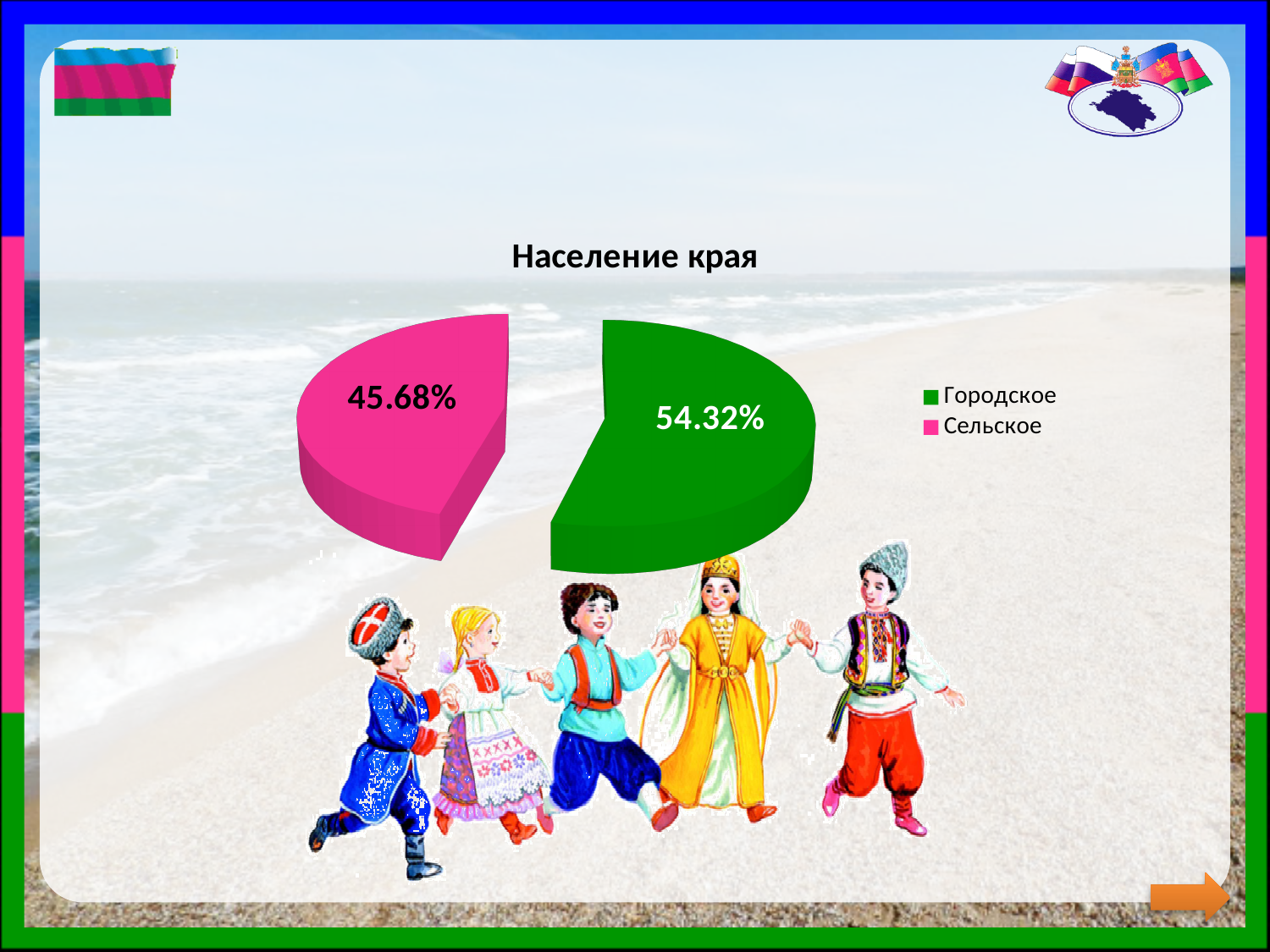
What is the title of the chart? Население края What is the difference between the Городское and Сельское values? 8.64% Which category has the smallest share of the pie? Сельское What is the value for Сельское? 45.68% What share of the pie does Городское represent? 54.32% Which is larger, Городское or Сельское? Городское How many entries does the legend list? 2 Which category has the largest share of the pie? Городское How many slices does the pie chart have? 2 What type of chart is shown on the slide? Pie chart What colour is the Сельское slice? Pink What is the value for Городское? 54.32%